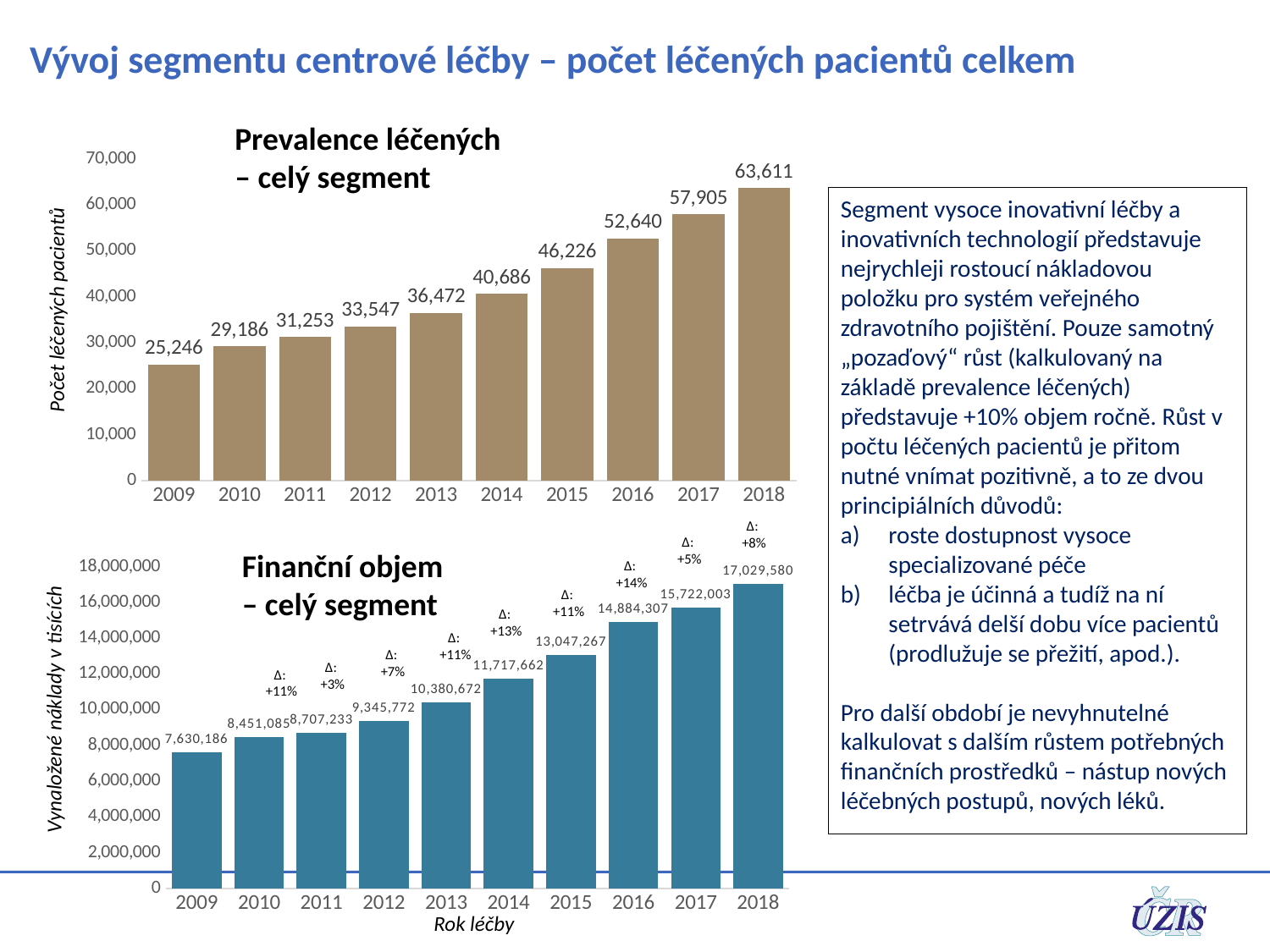
In the 'Prevalence léčených – celý segment' chart, what is the difference between the values for 2018 and 2009? 38,365 In the 'Finanční objem – celý segment' chart, what is the difference between the values for 2018 and 2017? 1,307,577 In the 'Prevalence léčených – celý segment' chart, what is the value for 2014? 40,686 What kind of chart is the 'Finanční objem – celý segment' chart? bar chart In the 'Prevalence léčených – celý segment' chart, which year has the highest value? 2018 In the 'Prevalence léčených – celý segment' chart, which year has the lowest value? 2009 In the 'Finanční objem – celý segment' chart, what is the value for 2018? 17,029,580 In the 'Finanční objem – celý segment' chart, what percentage change (Δ) is shown for 2016? +14% In the 'Finanční objem – celý segment' chart, which is larger, the value for 2015 or the value for 2016? 2016 In the 'Prevalence léčených – celý segment' chart, how many years are shown on the x axis? 10 In the 'Finanční objem – celý segment' chart, what is the value for 2013? 10,380,672 In the 'Prevalence léčených – celý segment' chart, do the values rise or fall from 2009 to 2018? rise